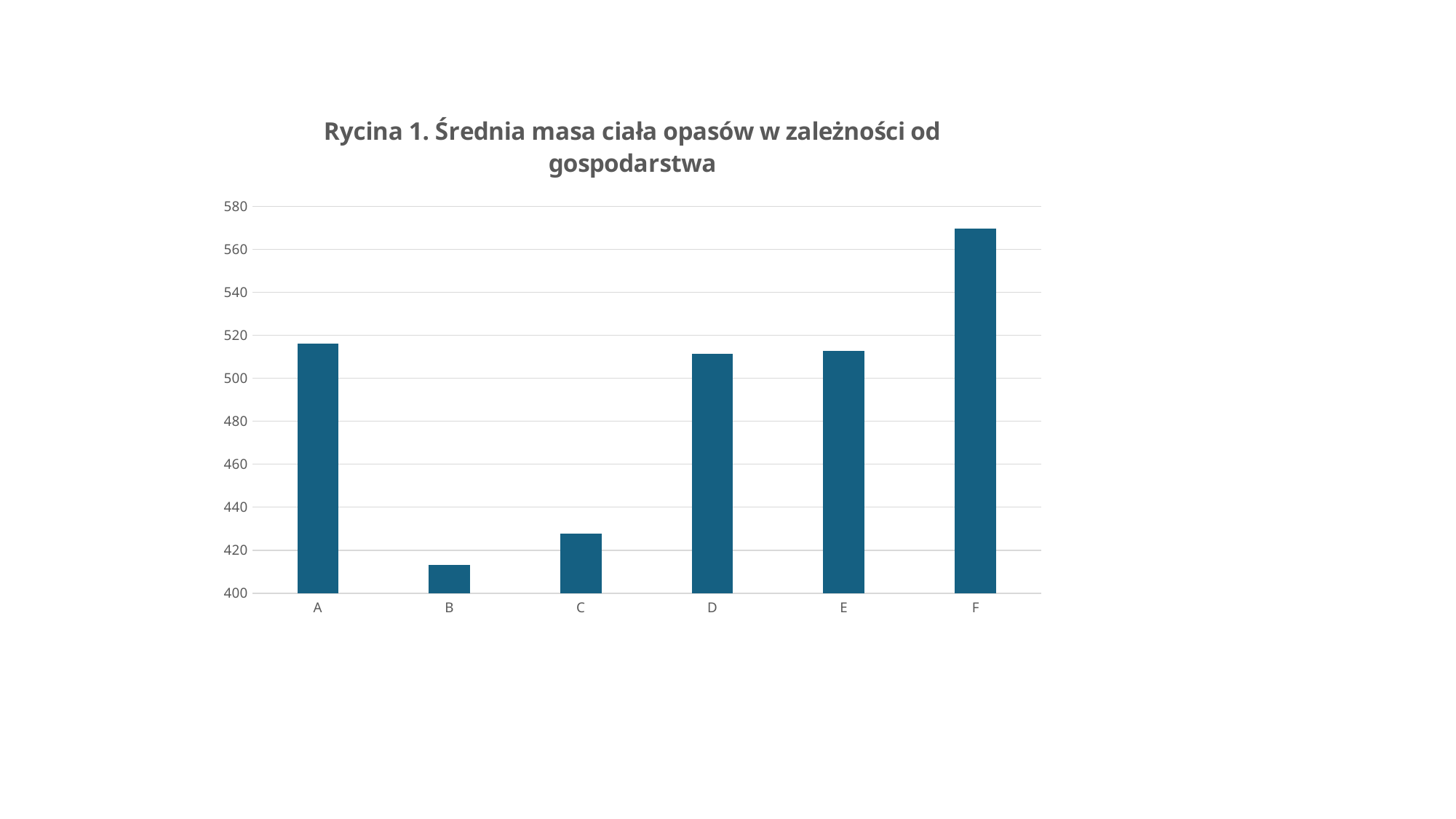
Is the value for C greater or less than 440? less Is the value for B greater or less than 420? less Which gospodarstwo has the highest average body mass? F Which is larger, the value for C or the value for F? F Is the value for A greater or less than 500? greater What is the title of the chart? Rycina 1. Średnia masa ciała opasów w zależności od gospodarstwa How many categories (gospodarstwa) are shown on the x axis? 6 Which is larger, the value for A or the value for B? A What kind of chart is shown on the slide? bar chart Which gospodarstwo has the lowest average body mass? B